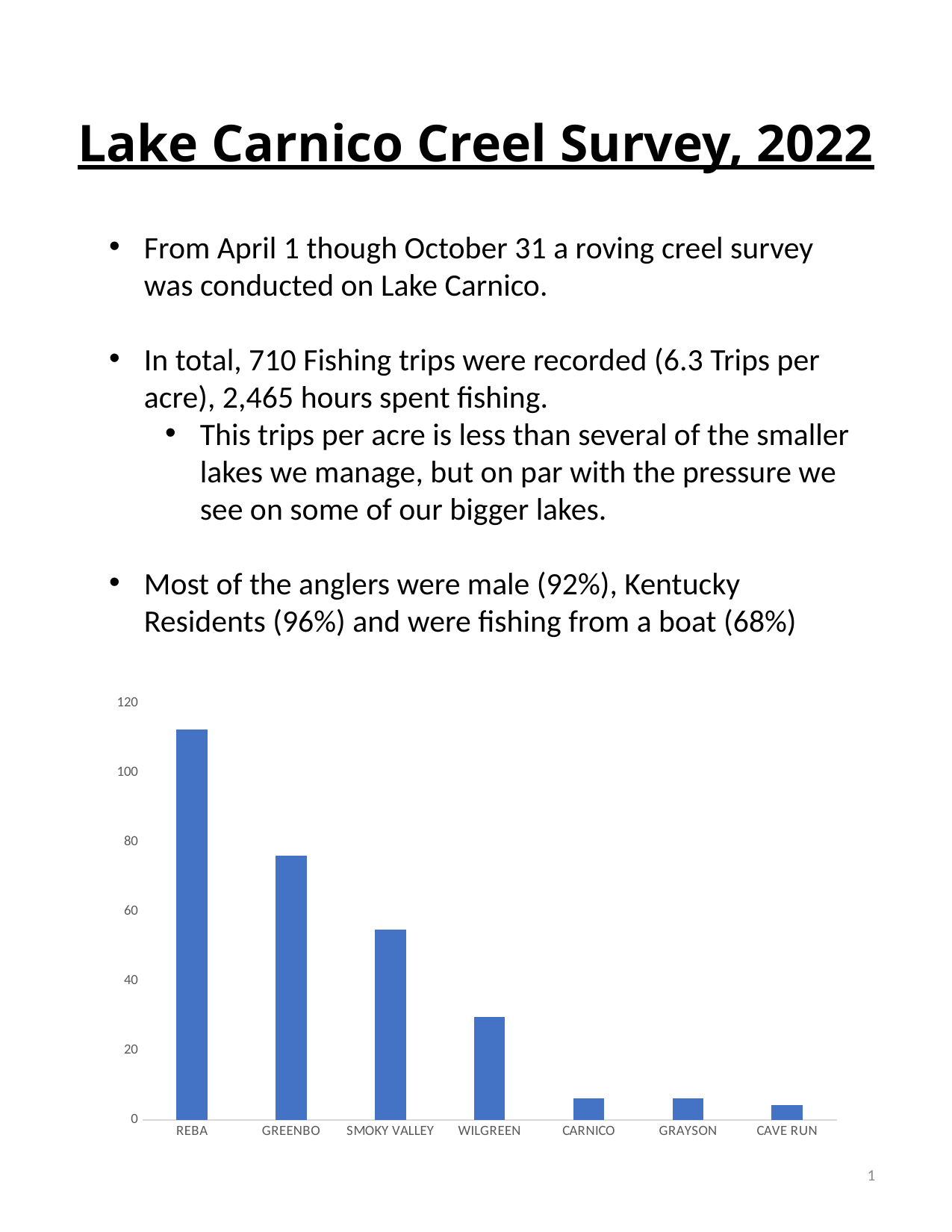
Which lake has the highest bar in the chart? REBA How many categories (lakes) are shown on the x axis of the chart? 7 Is the value for SMOKY VALLEY greater or less than 60? less What kind of chart is shown on the slide? bar chart Which is larger, the value for GREENBO or the value for SMOKY VALLEY? GREENBO Is the value for CARNICO greater or less than 20? less Which lake has the lowest bar in the chart? CAVE RUN Is the value for REBA greater or less than 100? greater What is the highest tick value shown on the vertical axis of the chart? 120 Do the bar values generally rise or fall moving from left to right along the x axis? fall